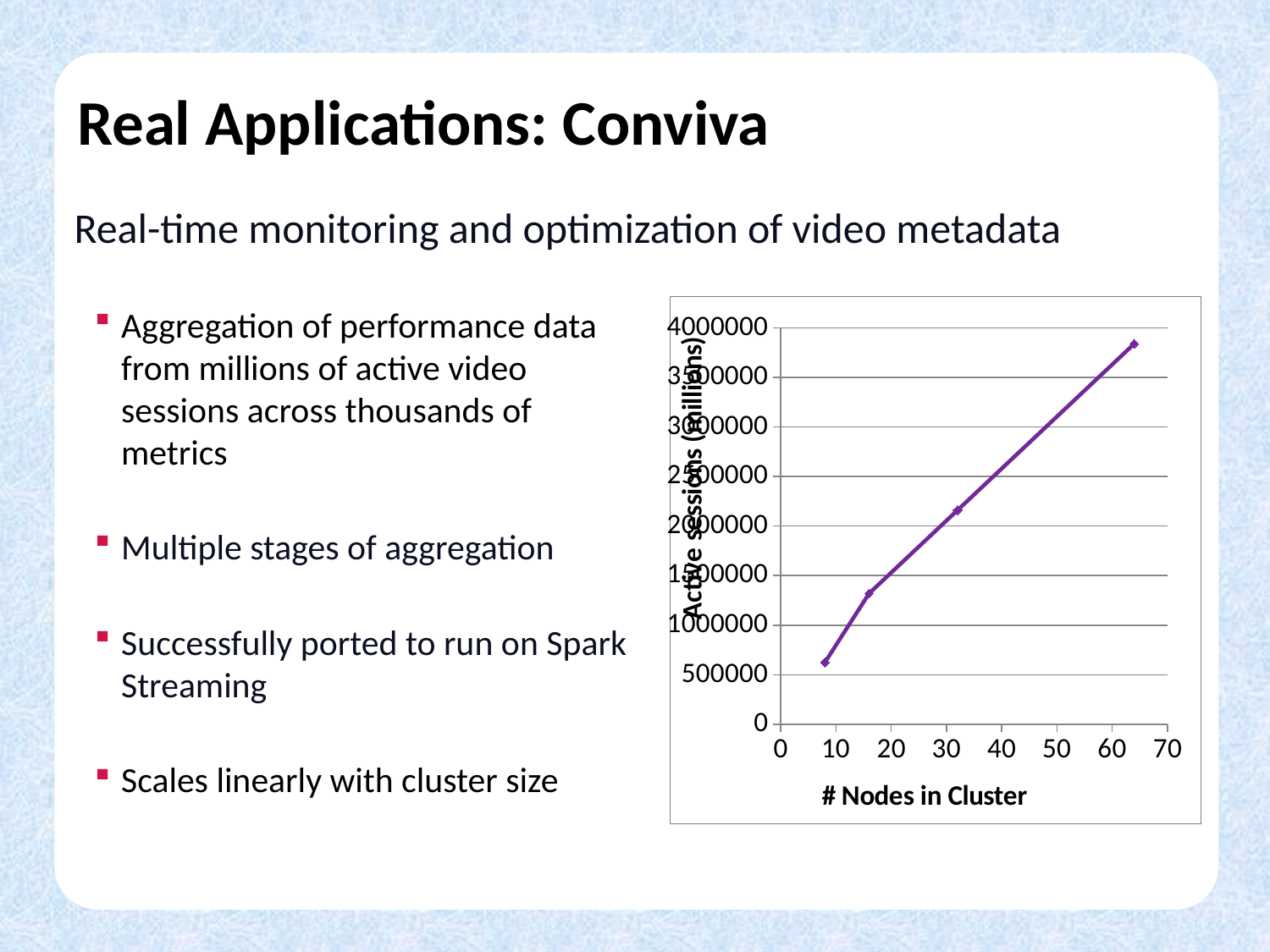
Which data point has the highest number of active sessions, the leftmost or the rightmost? the rightmost Is the value for the rightmost data point (around 64 nodes) greater or less than 3500000? greater Do active sessions rise or fall as the number of nodes in the cluster increases? rise How many data points are plotted on the line? 4 What is the highest tick value shown on the y axis? 4000000 What is the title of the y axis? Active sessions (millions) What is the title of the x axis? # Nodes in Cluster Is the value for the data point at around 32 nodes greater or less than 2500000? less What kind of chart is shown on the slide? line chart Is the value for the data point at around 16 nodes greater or less than 1500000? less Which data point has the lowest number of active sessions, the leftmost or the rightmost? the leftmost